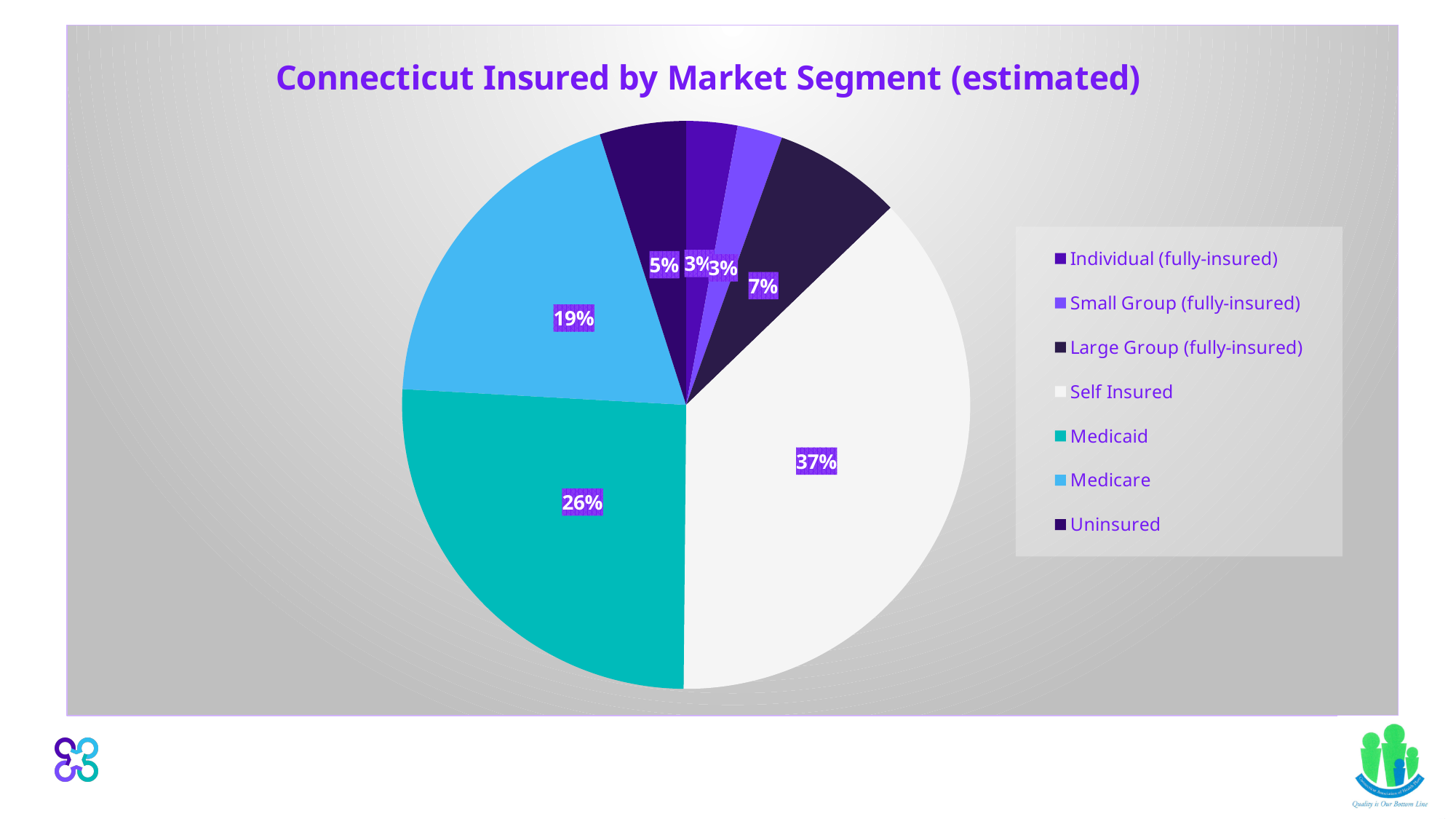
What share of the pie is Uninsured? 5% Which market segment has the largest share of the pie? Self Insured What share of the pie is Large Group (fully-insured)? 7% How many market segments does the legend list? 7 Which is larger, the Medicaid share or the Medicare share? Medicaid What colour is the Medicaid slice? teal What share of the pie is Self Insured? 37% What is the title of the chart? Connecticut Insured by Market Segment (estimated) What type of chart is shown on the slide? pie chart What is the difference between the Self Insured share and the Medicaid share? 11%